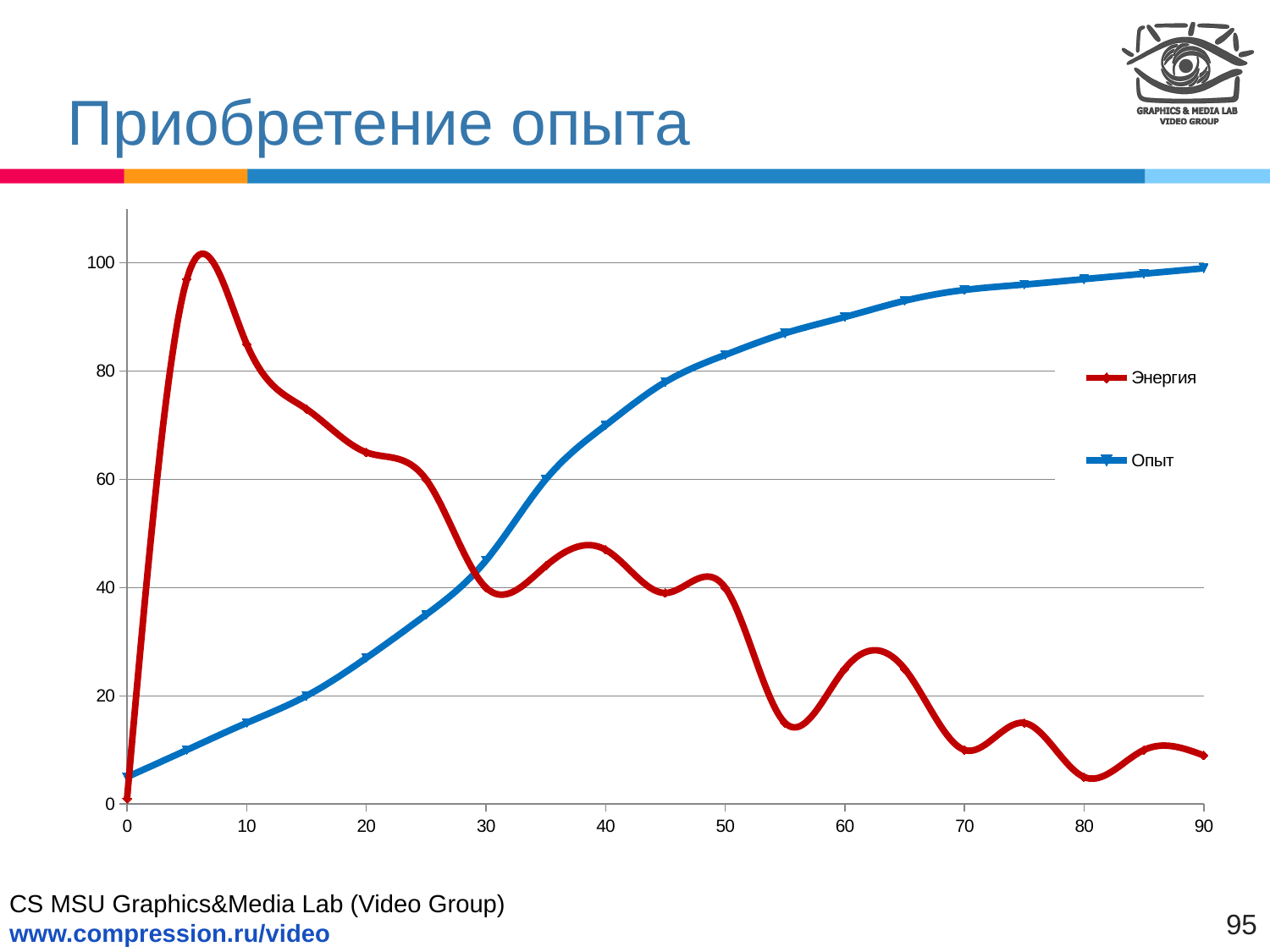
At x = 90, which series has the larger value, Энергия or Опыт? Опыт Is the value of Энергия at x = 90 greater or less than 20? less How many series does the legend list? 2 What is the title of the slide containing the chart? Приобретение опыта Is the value of Опыт at x = 0 greater or less than 20? less Which colour is used for the Энергия series? red Is the value of Опыт at x = 20 greater or less than 40? less What kind of chart is shown on the slide? line chart At x = 10, which series has the larger value, Энергия or Опыт? Энергия Does the Опыт series rise or fall as x increases from 0 to 90? rises